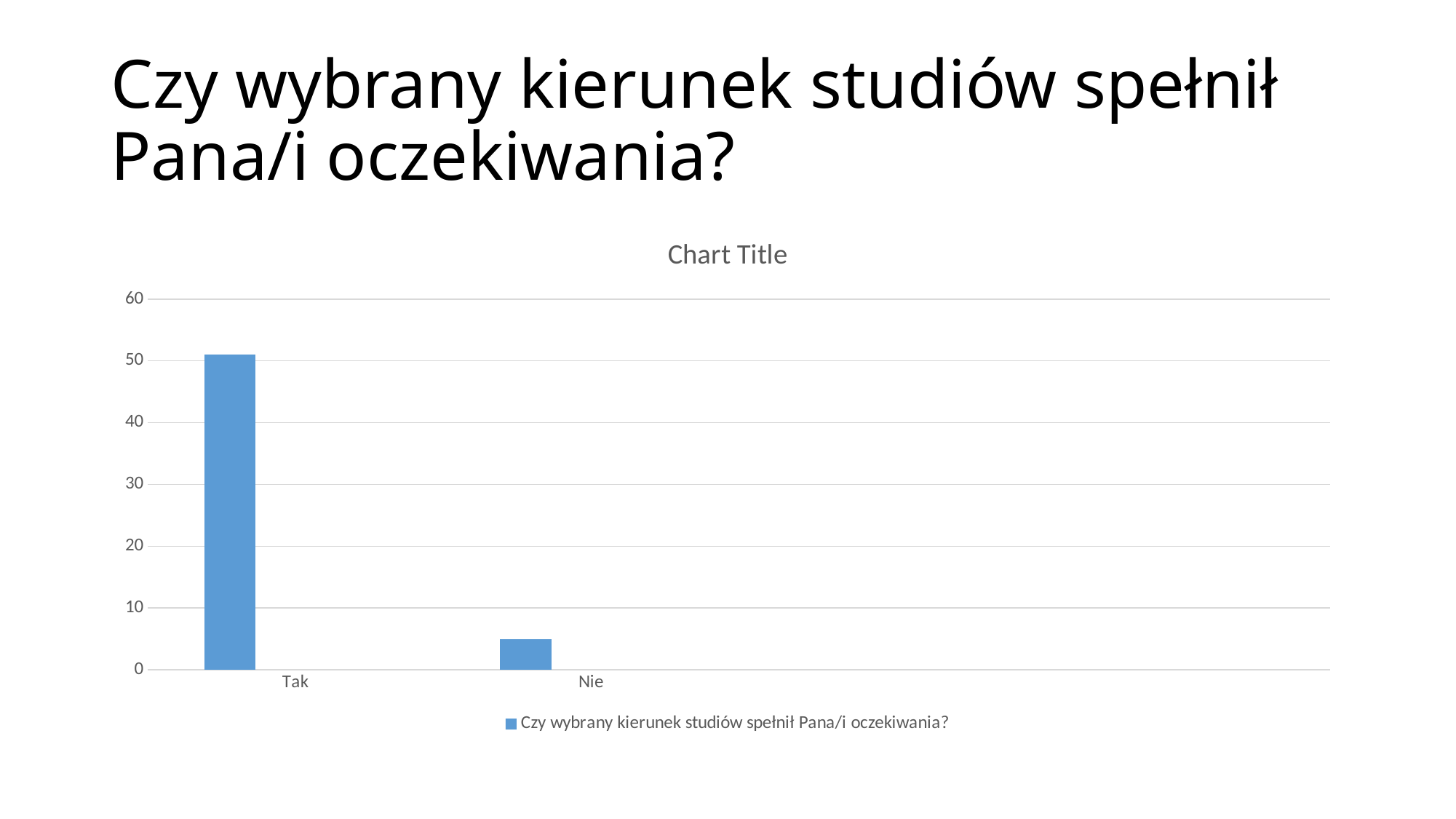
How many categories are shown on the x axis of the chart? 2 What is the title shown above the chart? Chart Title How many series does the chart legend list? 1 What is the legend entry shown below the chart? Czy wybrany kierunek studiów spełnił Pana/i oczekiwania? Which category has the lowest bar in the chart? Nie Is the value for Tak greater or less than 40? greater What kind of chart is shown on the slide? bar chart Is the value for Tak greater or less than 60? less Is the value for Nie greater or less than 10? less Which category has the highest bar in the chart? Tak Which is larger, the value for Tak or the value for Nie? Tak